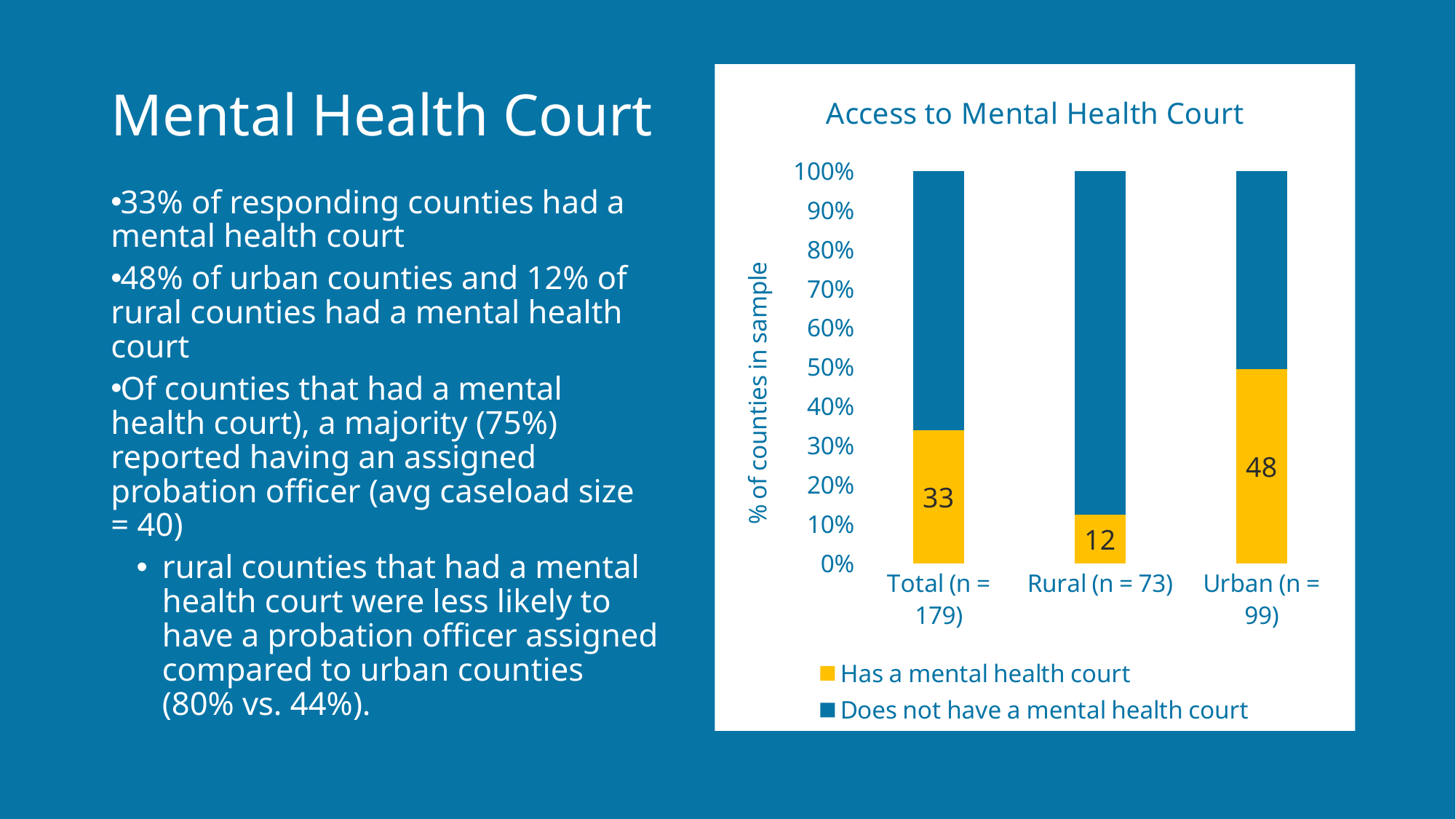
What is the difference between the 'Has a mental health court' values for Total (n = 179) and Rural (n = 73)? 21 How many categories are shown on the x axis of the chart? 3 What is the difference between the 'Has a mental health court' values for Urban (n = 99) and Rural (n = 73)? 36 Is the 'Does not have a mental health court' share for Rural (n = 73) greater or less than 80%? greater What type of chart is shown on the slide? Stacked bar chart What percentage of rural counties (n = 73) has a mental health court? 12 Which has a larger 'Has a mental health court' value, Urban (n = 99) or Total (n = 179)? Urban (n = 99) What is the value for 'Has a mental health court' for Urban (n = 99)? 48 How many series does the chart legend list? 2 What is the value for 'Has a mental health court' for Total (n = 179)? 33 Which category has the highest value for 'Has a mental health court'? Urban (n = 99) Which category has the lowest value for 'Has a mental health court'? Rural (n = 73)